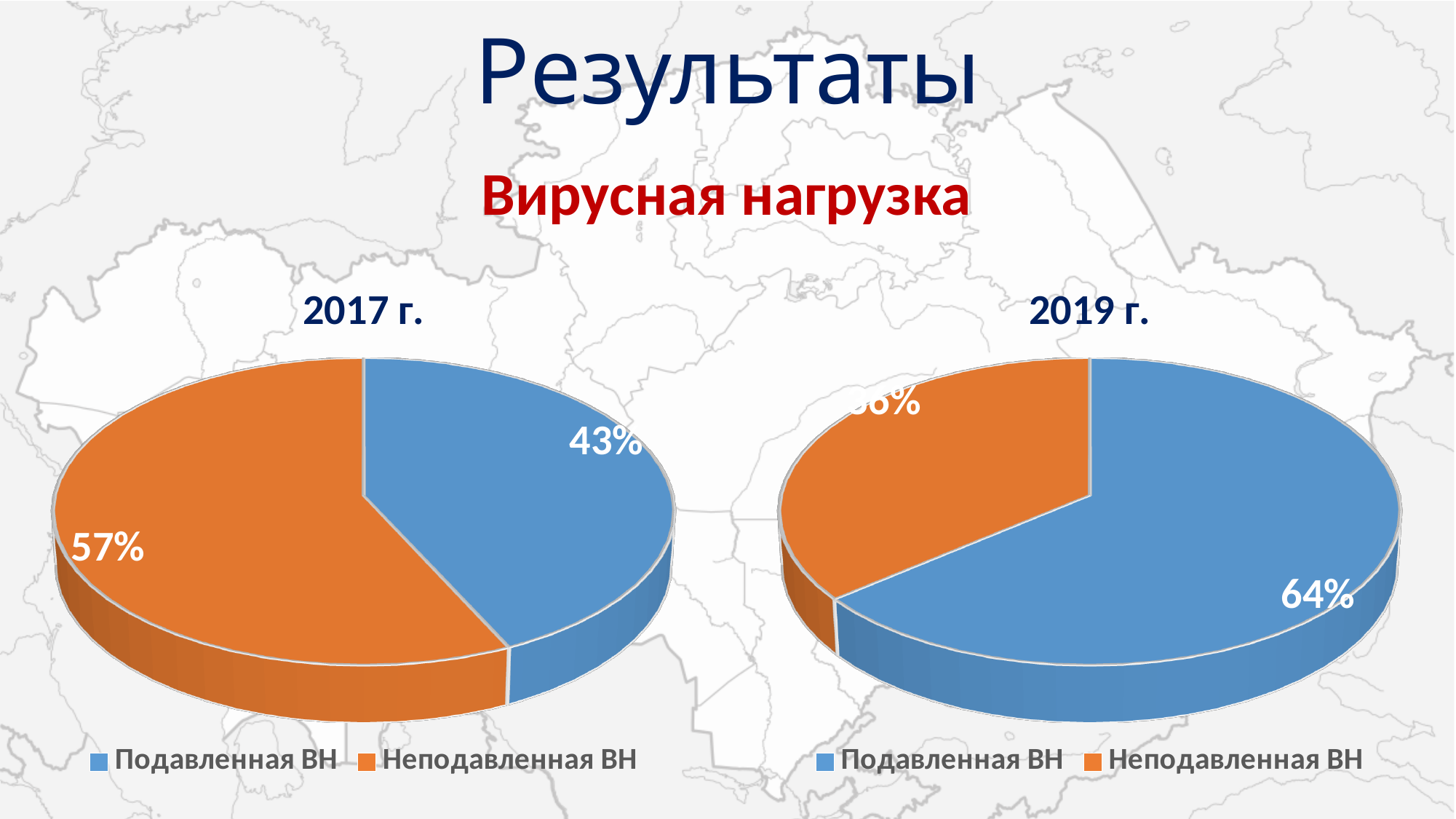
How many entries does the legend of the 2017 г. pie chart list? 2 In the 2017 г. pie chart, what is the difference between the Неподавленная ВН share and the Подавленная ВН share? 14% What colour represents Неподавленная ВН in the pie charts? Orange What is the difference between the Подавленная ВН share in 2019 г. and in 2017 г.? 21% In the 2019 г. pie chart, what percentage is shown for Подавленная ВН? 64% How many categories does the 2019 г. pie chart show? 2 In the 2017 г. pie chart, what percentage is shown for Неподавленная ВН? 57% In the 2017 г. pie chart, what percentage is shown for Подавленная ВН? 43% In the 2019 г. pie chart, which category has the larger share? Подавленная ВН What type of chart is used for the 2017 г. data? Pie chart In the 2017 г. pie chart, which category has the larger share? Неподавленная ВН Which is larger: the Подавленная ВН share in 2017 г. or in 2019 г.? 2019 г.